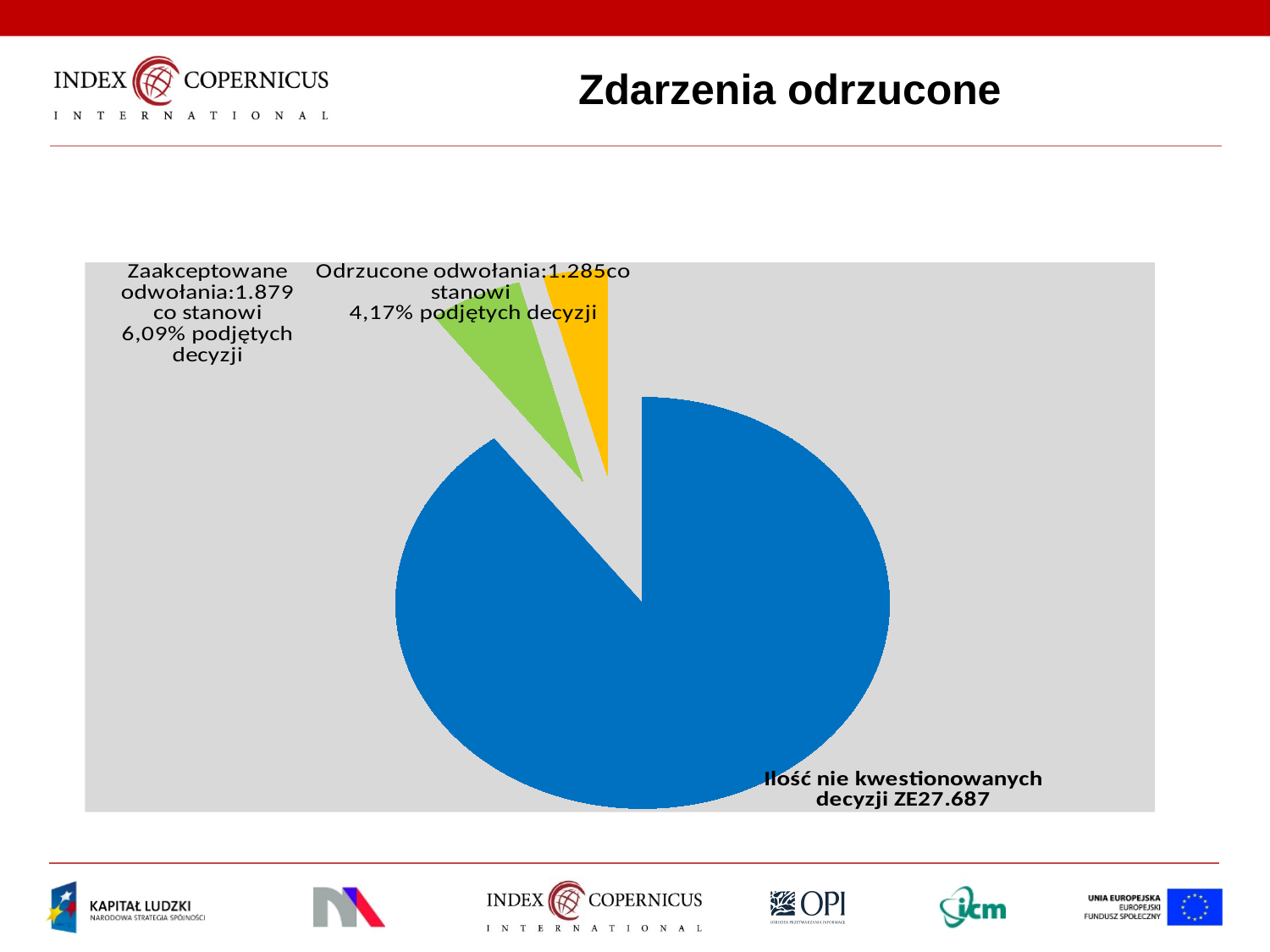
How many slices does the pie chart have? 3 What is the title of the slide containing the pie chart? Zdarzenia odrzucone Which slice of the pie chart is the smallest? Odrzucone odwołania What kind of chart is shown on the slide? pie chart Which slice of the pie chart is the largest? Ilość nie kwestionowanych decyzji ZE Which is larger: the number of accepted appeals (Zaakceptowane odwołania) or the number of rejected appeals (Odrzucone odwołania)? Zaakceptowane odwołania What is the number of accepted appeals (Zaakceptowane odwołania) shown on the chart? 1.879 What is the difference between the number of accepted appeals (1.879) and rejected appeals (1.285)? 594 What share of the decisions do the rejected appeals (Odrzucone odwołania) represent? 4,17% What is the number of uncontested decisions (Ilość nie kwestionowanych decyzji ZE) shown on the chart? 27.687 What share of the decisions do the accepted appeals (Zaakceptowane odwołania) represent? 6,09% What is the number of rejected appeals (Odrzucone odwołania) shown on the chart? 1.285